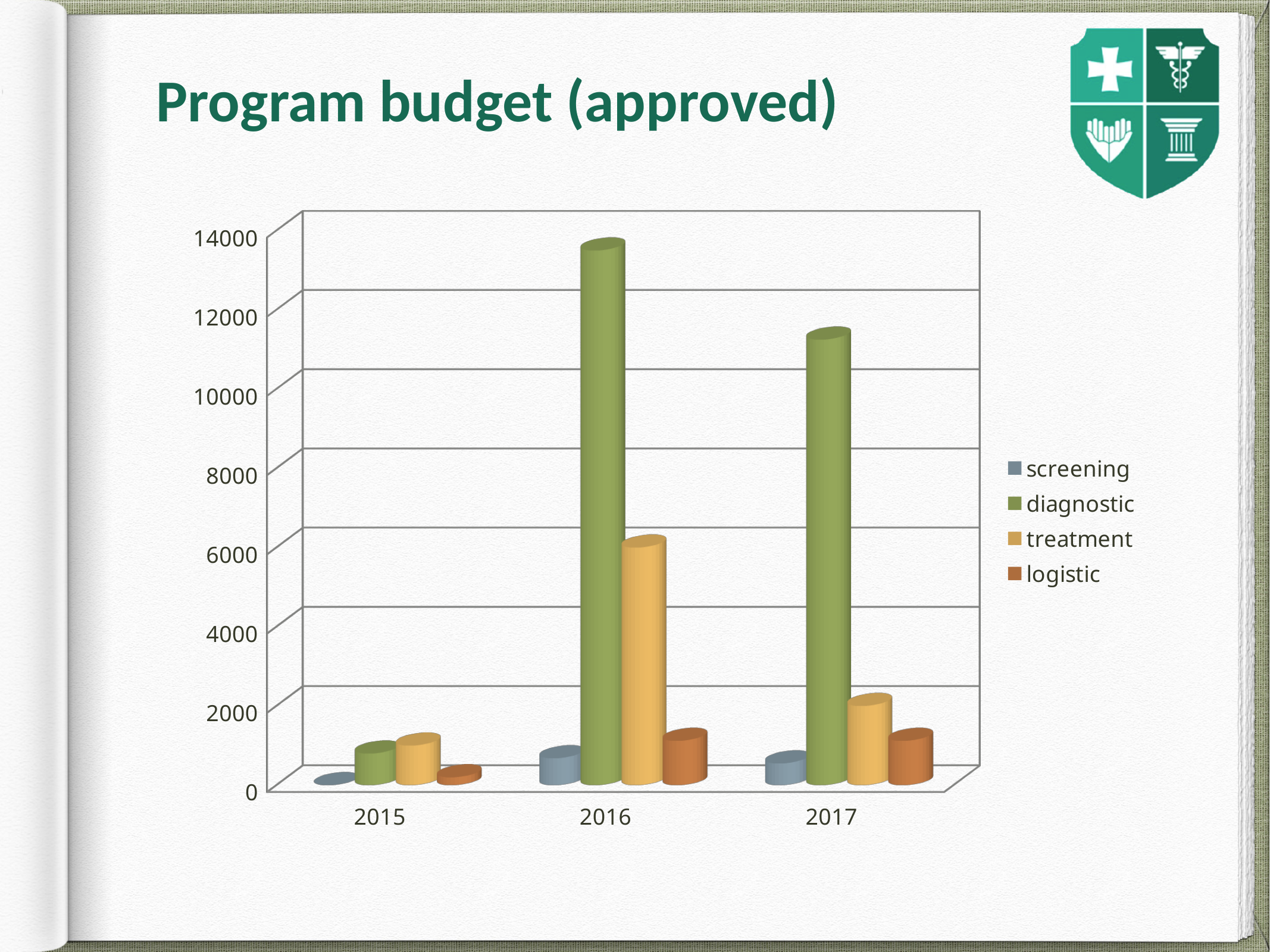
Is the diagnostic value for 2016 greater or less than 12000? greater Is the logistic value for 2016 greater or less than 2000? less Which is larger, the diagnostic value for 2016 or for 2017? 2016 Which series has the lowest bar in 2015? screening Which is larger, the treatment value for 2016 or for 2017? 2016 Which series has the tallest bar in 2016? diagnostic What kind of chart is shown on the slide? bar chart Which colour represents the diagnostic series in the legend? green How many years are shown on the x axis? 3 Is the diagnostic value for 2017 greater or less than 10000? greater How many series does the legend list? 4 What is the title of the chart? Program budget (approved)